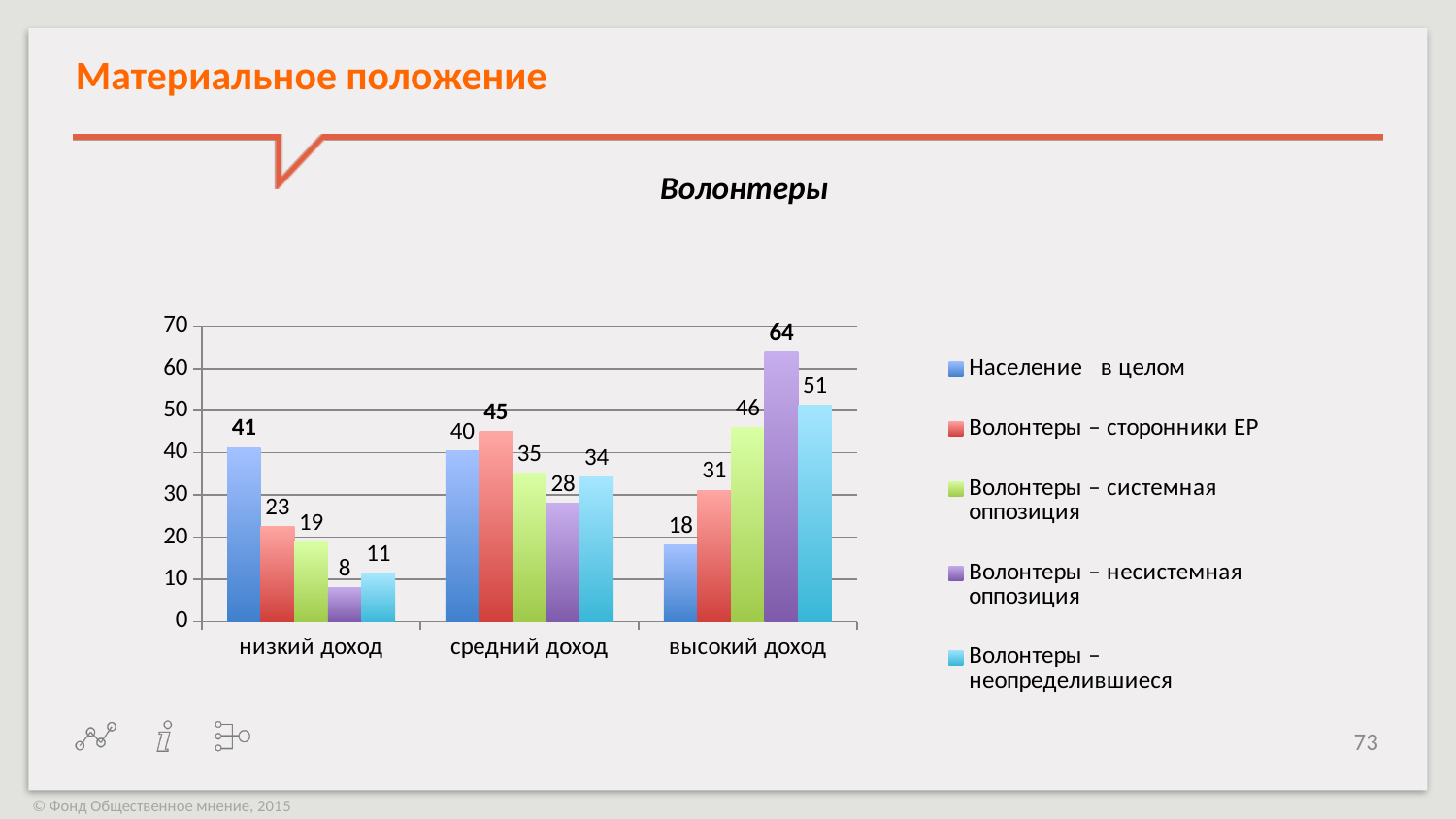
Which series has the highest value in the "высокий доход" category? Волонтеры – несистемная оппозиция What kind of chart is shown on the slide? bar chart What is the value for "Волонтеры – неопределившиеся" in the "средний доход" category? 34 What is the title shown above the chart? Волонтеры Which series has the lowest value in the "низкий доход" category? Волонтеры – несистемная оппозиция What is the value for "Население в целом" in the "низкий доход" category? 41 What is the value for "Волонтеры – несистемная оппозиция" in the "высокий доход" category? 64 Do the values for "Волонтеры – несистемная оппозиция" rise or fall from "низкий доход" to "высокий доход"? rise How many income categories are shown on the x axis? 3 How many series does the legend list? 5 What is the difference between the values for "Волонтеры – несистемная оппозиция" and "Население в целом" in the "высокий доход" category? 46 In the "средний доход" category, which is larger: "Волонтеры – сторонники ЕР" or "Волонтеры – системная оппозиция"? Волонтеры – сторонники ЕР